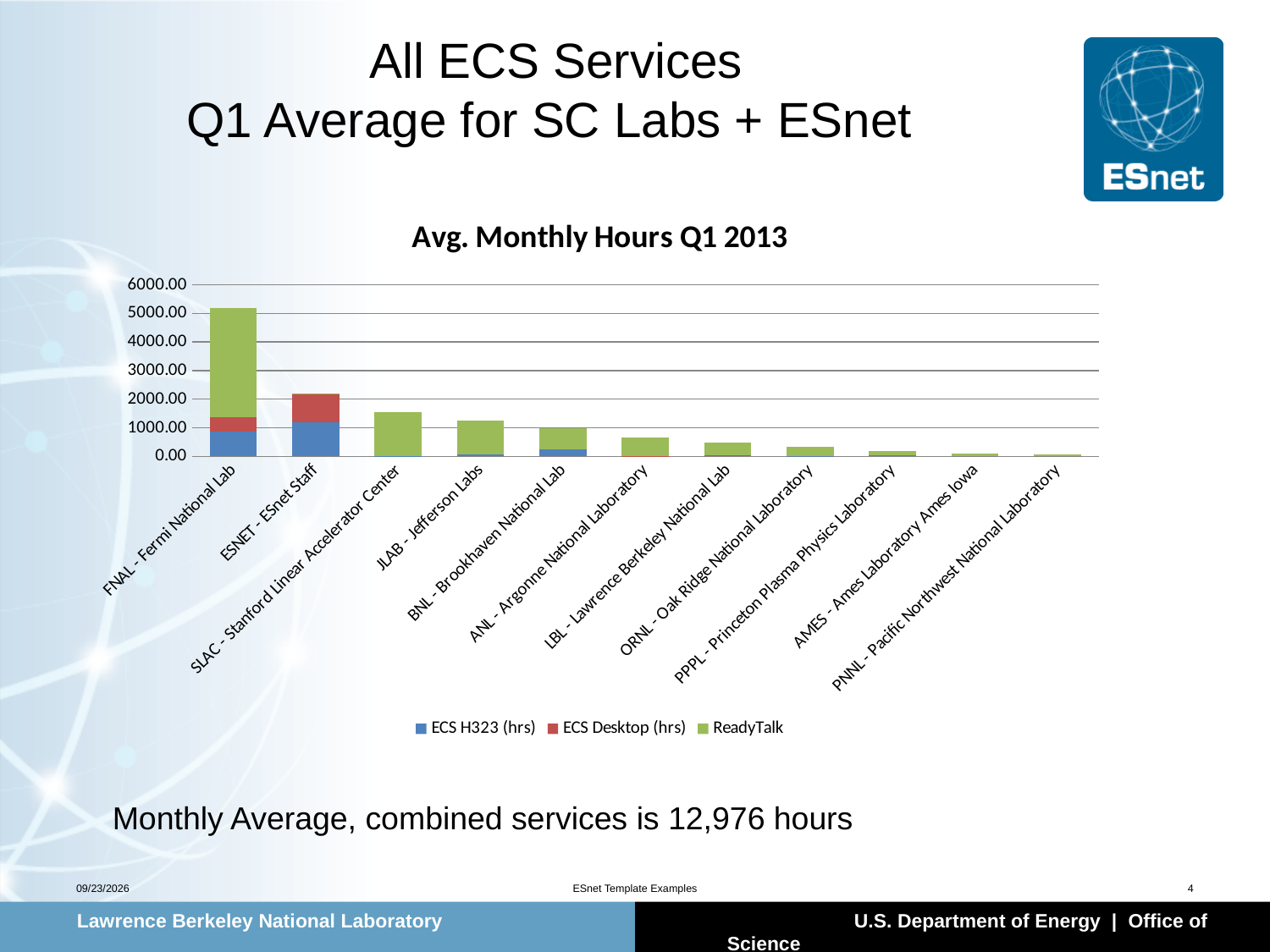
Which series are listed in the chart legend? ECS H323 (hrs), ECS Desktop (hrs), ReadyTalk What is the title of the chart? Avg. Monthly Hours Q1 2013 Is the total bar for FNAL - Fermi National Lab greater or less than 5000.00? greater Is the total bar for SLAC - Stanford Linear Accelerator Center greater or less than 1000.00? greater What kind of chart is shown on the slide? stacked bar chart Is the total bar for ANL - Argonne National Laboratory greater or less than 1000.00? less Which lab has the tallest stacked bar in the chart? FNAL - Fermi National Lab How many labs or organizations are shown on the x axis of the chart? 11 How many series does the chart legend list? 3 Do the total bar heights rise or fall moving from left to right along the x axis? fall Which has a taller stacked bar, JLAB - Jefferson Labs or LBL - Lawrence Berkeley National Lab? JLAB - Jefferson Labs